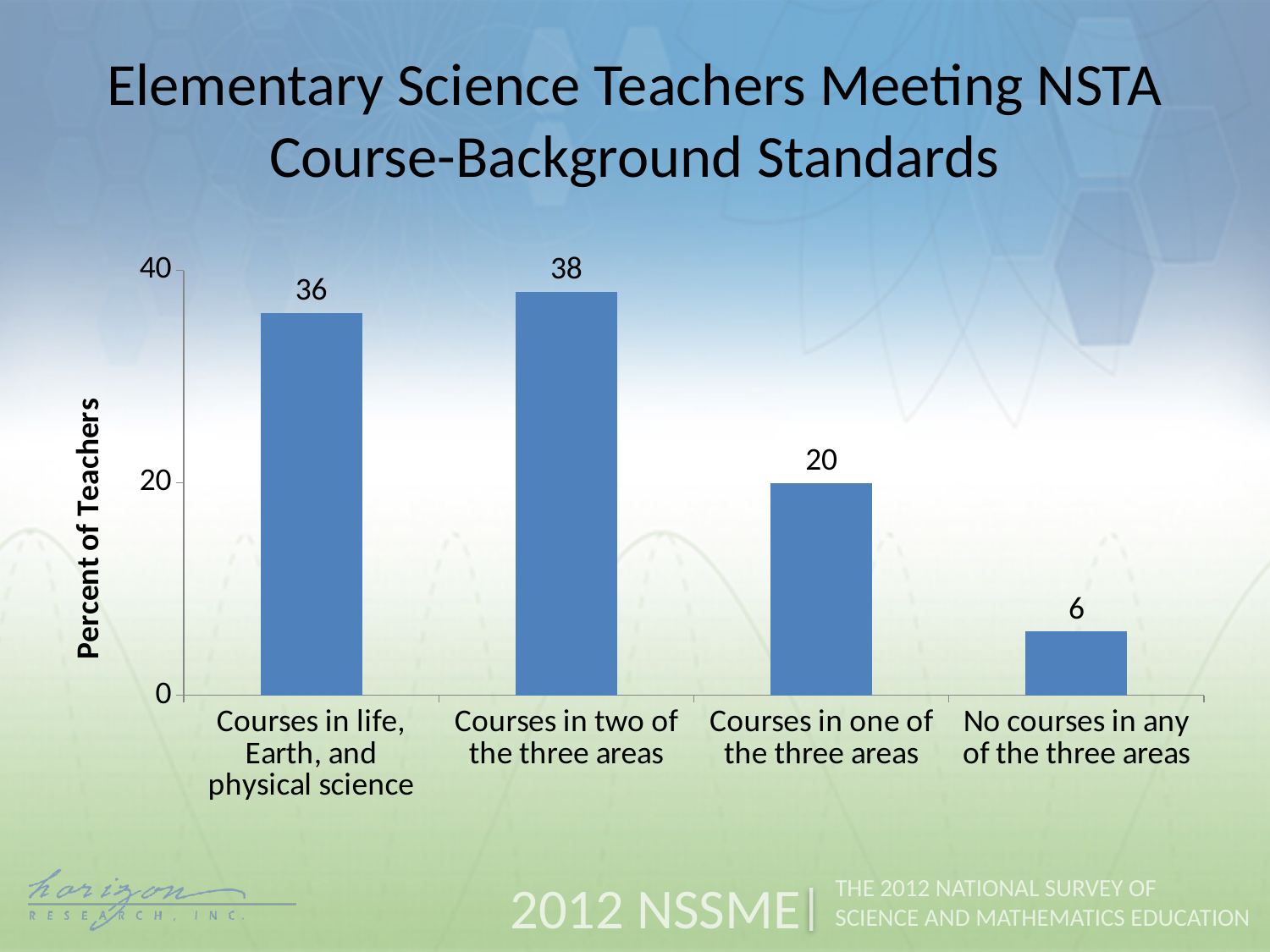
What percent of teachers had courses in life, Earth, and physical science? 36 What is the label of the y axis? Percent of Teachers What is the title of the chart? Elementary Science Teachers Meeting NSTA Course-Background Standards What percent of teachers had no courses in any of the three areas? 6 How many categories are shown on the x axis? 4 What kind of chart is shown on the slide? Bar chart Which category has the highest percent of teachers? Courses in two of the three areas Which category has the lowest percent of teachers? No courses in any of the three areas What percent of teachers had courses in two of the three areas? 38 What is the difference in percent of teachers between courses in two of the three areas and courses in one of the three areas? 18 Which is larger: the percent of teachers with courses in one of the three areas or with no courses in any of the three areas? Courses in one of the three areas Is the value for courses in one of the three areas greater or less than 40? less